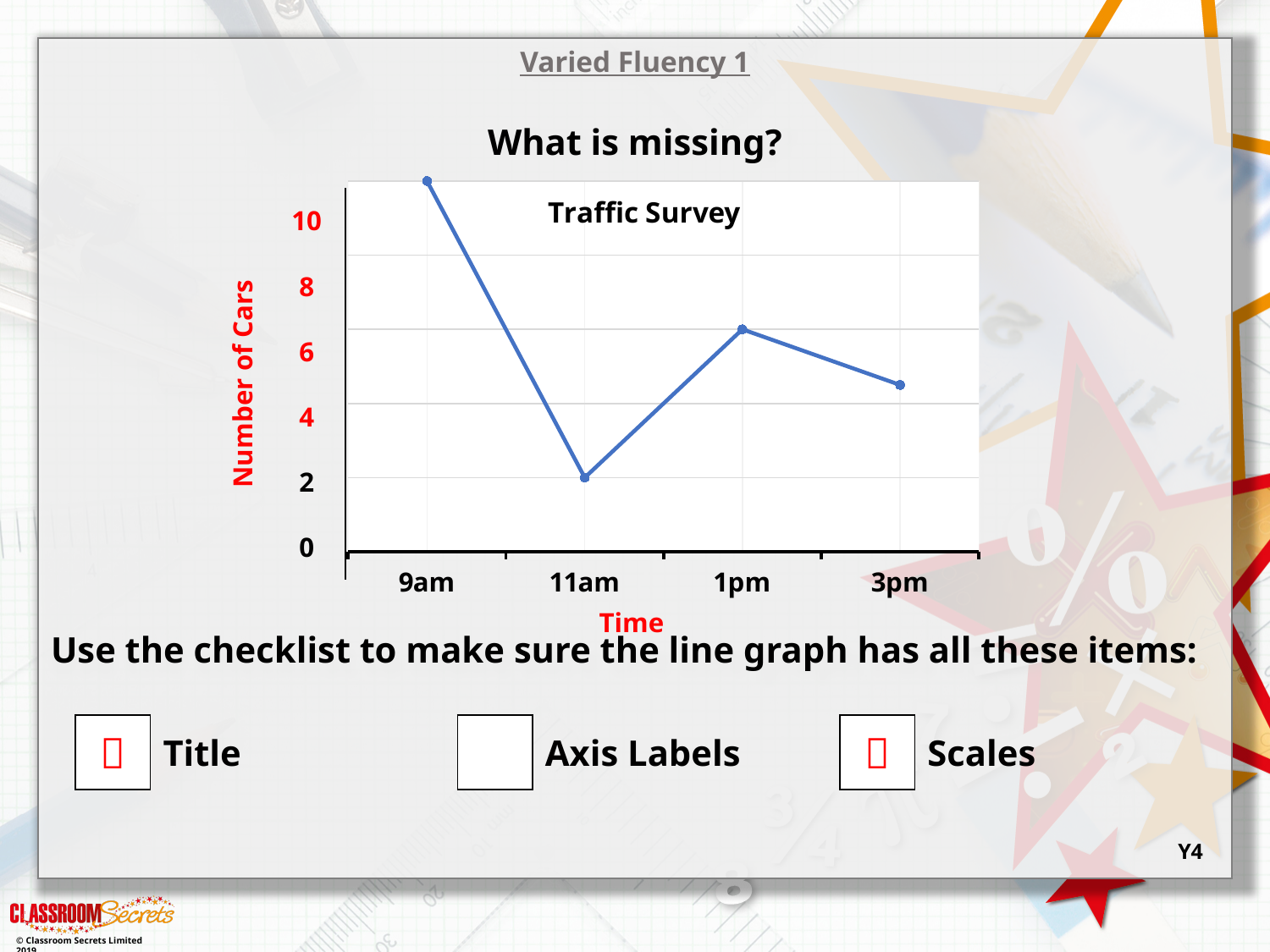
At which time was the number of cars highest? 9am How many time points are plotted on the chart? 4 Does the number of cars rise or fall between 9am and 11am? fall Is the number of cars at 3pm greater or less than 6? less What is the label on the vertical axis of the chart? Number of Cars At which time was the number of cars lowest? 11am What is the title of the chart? Traffic Survey Which time has more cars, 1pm or 3pm? 1pm What is the number of cars at 11am? 2 What kind of chart is shown on the slide? line chart